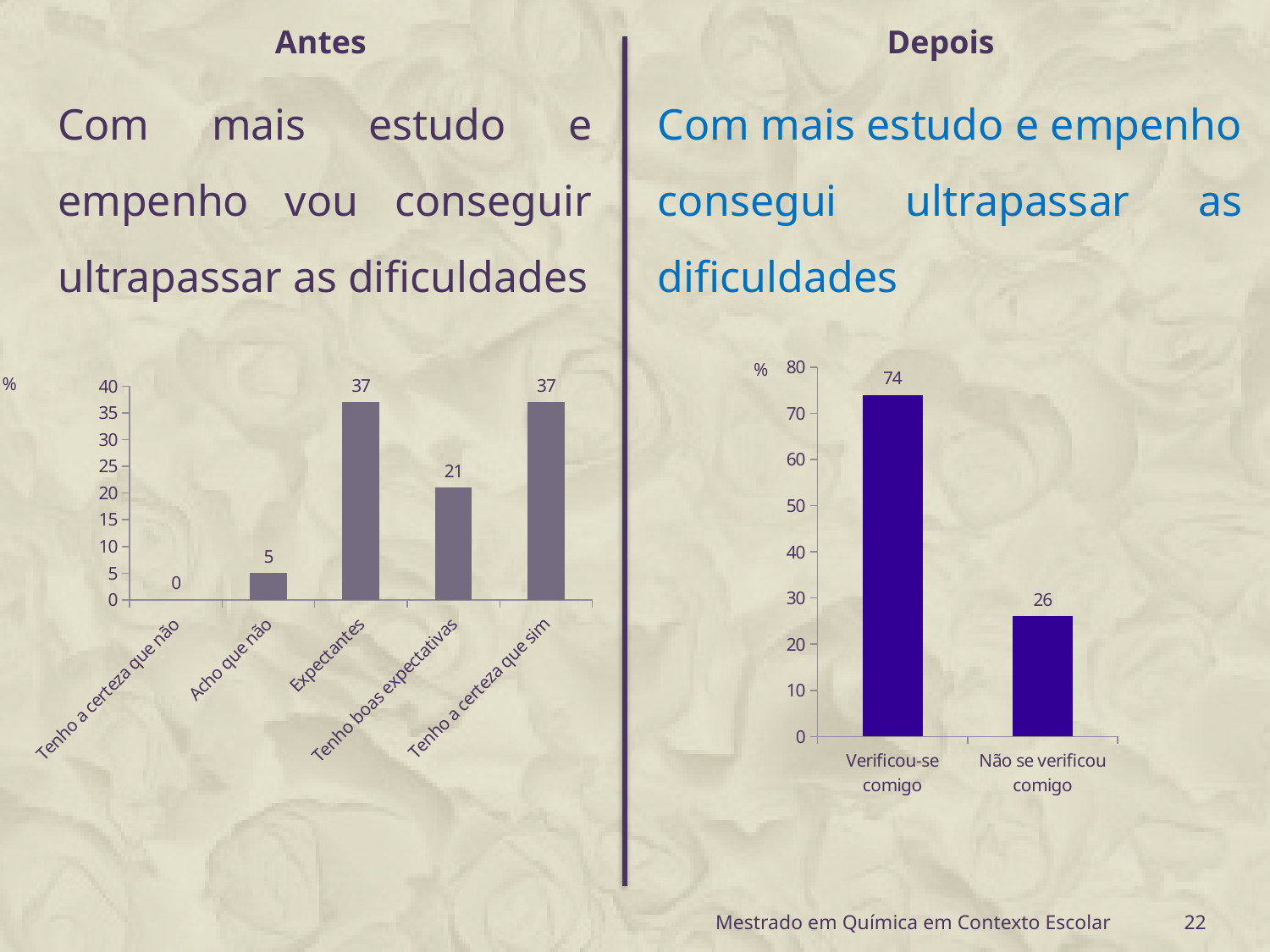
In the right chart (Depois), what is the difference between the values for "Verificou-se comigo" and "Não se verificou comigo"? 48 In the left chart (Antes), what is the value for "Tenho boas expectativas"? 21 In the right chart (Depois), which category has the highest value? Verificou-se comigo In the left chart (Antes), what is the difference between the values for "Expectantes" and "Tenho boas expectativas"? 16 In the left chart (Antes), which is larger: the value for "Tenho boas expectativas" or the value for "Acho que não"? Tenho boas expectativas In the right chart (Depois), what is the value for "Não se verificou comigo"? 26 In the left chart (Antes), what is the value for "Acho que não"? 5 In the left chart (Antes), what is the value for "Expectantes"? 37 In the left chart (Antes), which category has the lowest value? Tenho a certeza que não What type of chart is the right chart (Depois)? Bar chart How many categories are shown in the left chart (Antes)? 5 In the right chart (Depois), what is the value for "Verificou-se comigo"? 74